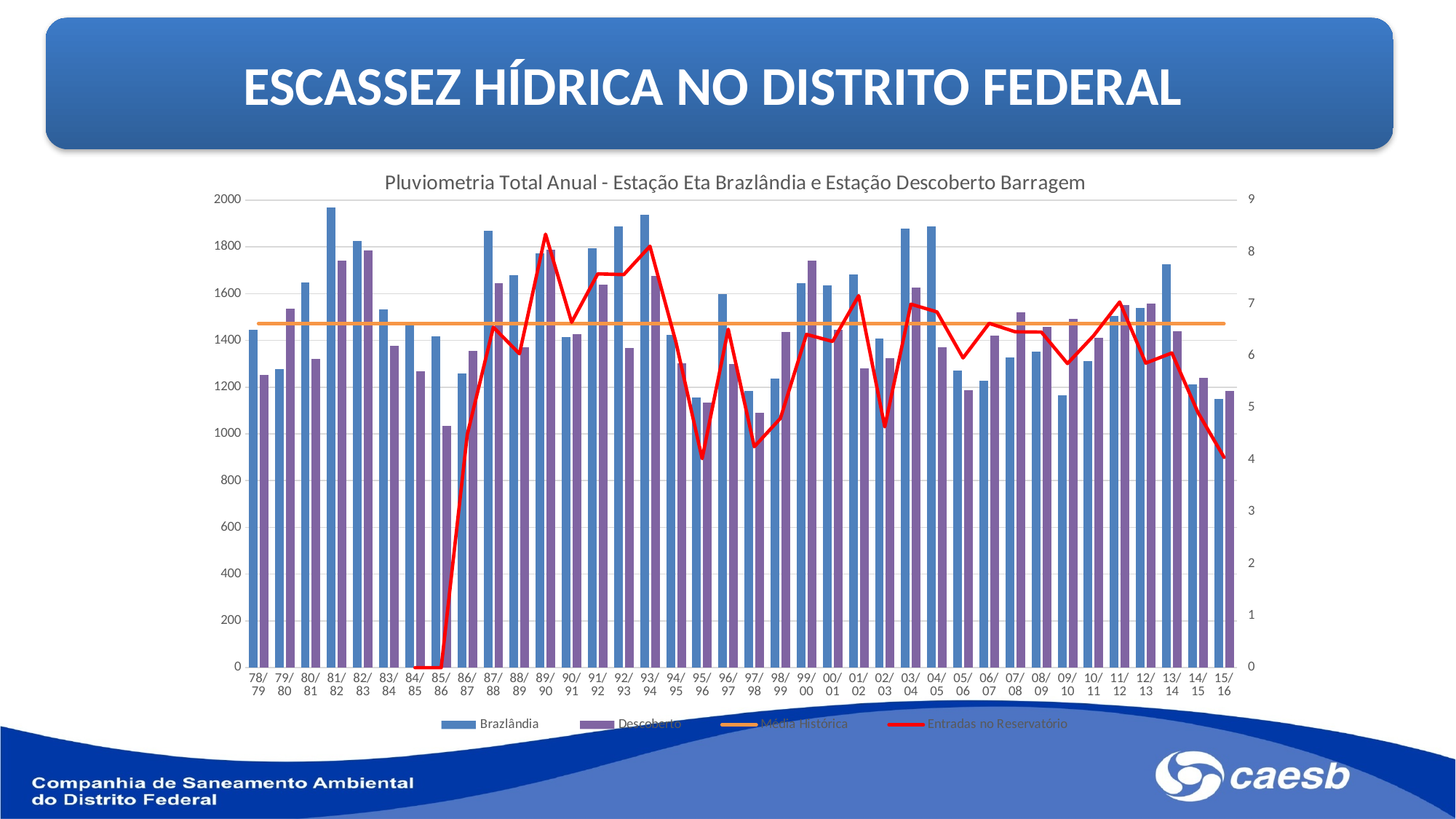
Is the Entradas no Reservatório value for 89/90 (right axis) greater or less than 8? greater Does the Entradas no Reservatório line rise or fall from 12/13 to 15/16? fall Which year has the lowest Descoberto value? 85/86 Is the Entradas no Reservatório value for 15/16 (right axis) greater or less than 5? less What kind of chart is shown on the slide? bar chart with line series Is the Descoberto value for 85/86 greater or less than 1200? less In 99/00, which is larger: the Brazlândia bar or the Descoberto bar? Descoberto How many hydrological years (categories) are shown on the x axis? 38 How many series does the legend list? 4 What is the title of the chart? Pluviometria Total Anual - Estação Eta Brazlândia e Estação Descoberto Barragem In 87/88, which is larger: the Brazlândia bar or the Descoberto bar? Brazlândia